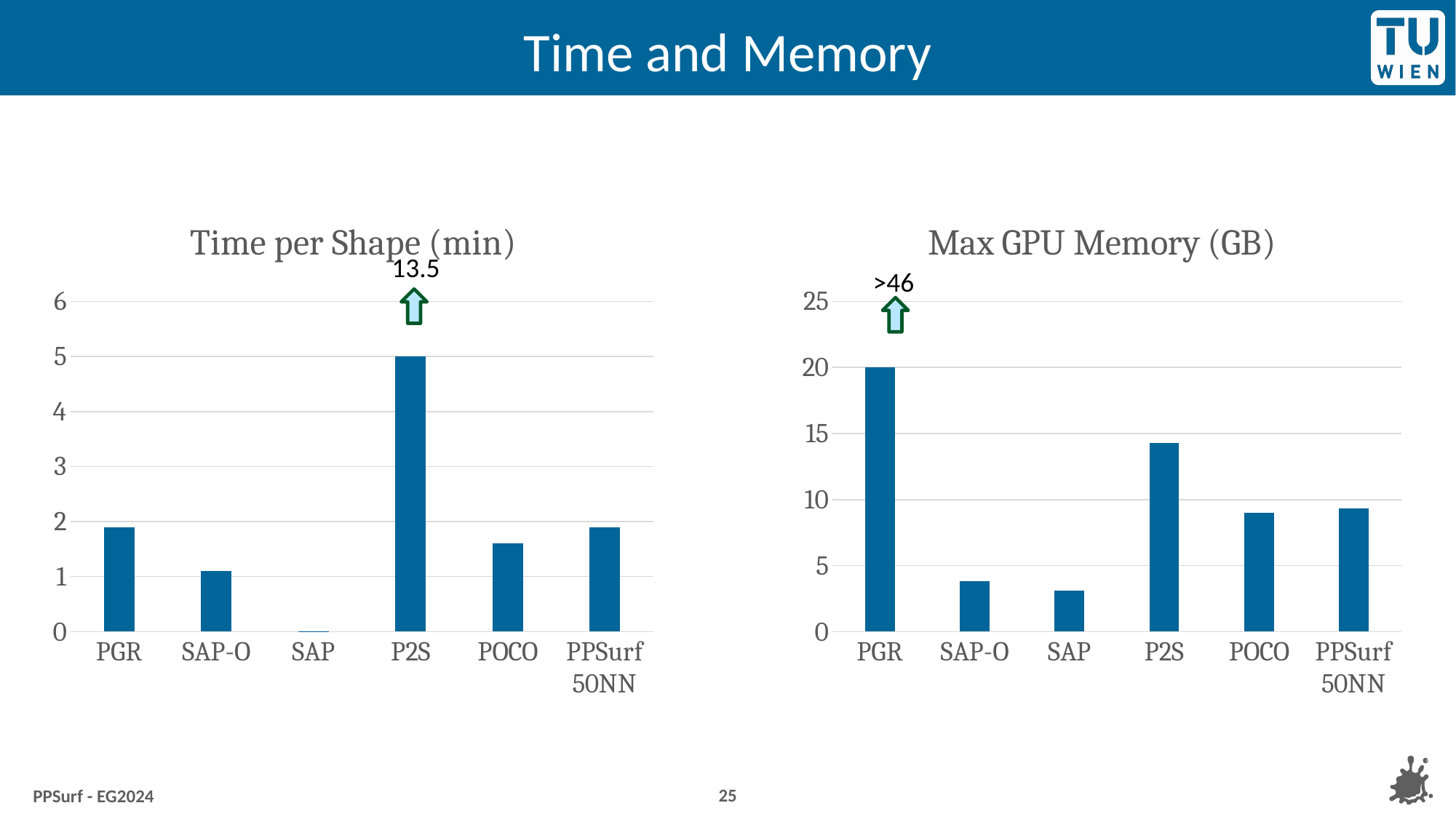
On the Time per Shape (min) chart, is the value for SAP-O greater or less than 2? less On the Time per Shape (min) chart, which method has the highest time? P2S On the Time per Shape (min) chart, which method has the lowest time? SAP On the Time per Shape (min) chart, what value is labelled for P2S? 13.5 What kind of chart is the Time per Shape (min) chart? bar chart On the Time per Shape (min) chart, which takes longer, POCO or SAP-O? POCO On the Max GPU Memory (GB) chart, which uses more memory, P2S or POCO? P2S On the Max GPU Memory (GB) chart, is the value for P2S greater or less than 10? greater On the Max GPU Memory (GB) chart, which method uses the least memory? SAP On the Max GPU Memory (GB) chart, what value is labelled for PGR? >46 How many methods are shown on the Max GPU Memory (GB) chart? 6 On the Max GPU Memory (GB) chart, which method uses the most memory? PGR